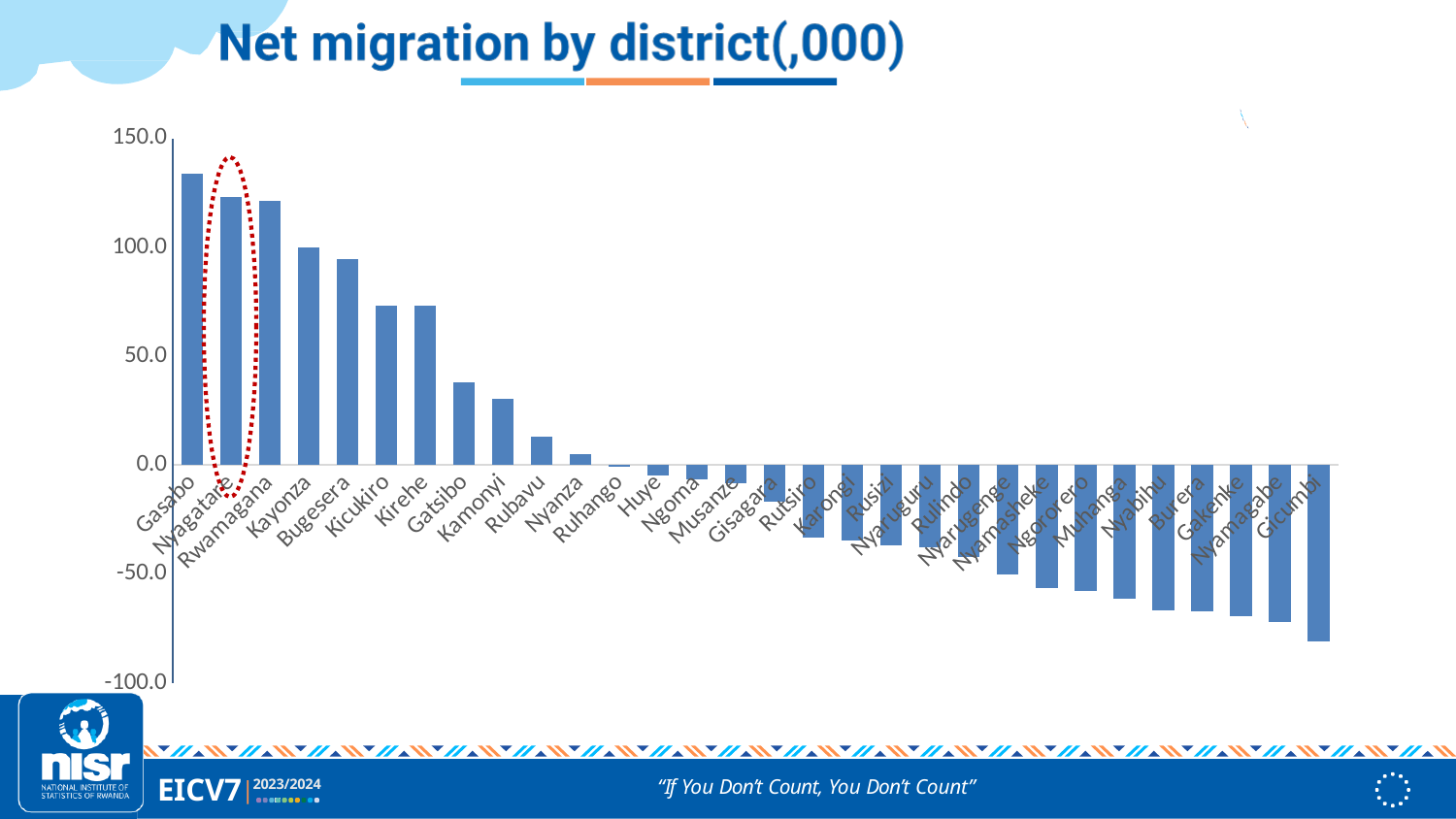
Is the value for Gasabo greater or less than 100.0? greater Is the value for Gatsibo greater or less than 50.0? less Is the value for Bugesera greater or less than 100.0? less Which district's bar is highlighted with a red dotted circle? Nyagatare Which district has the highest net migration? Gasabo Which district has the lowest net migration? Gicumbi Which has the larger net migration, Gasabo or Nyagatare? Gasabo Do the values generally rise or fall moving from left to right along the x axis? fall How many districts are shown on the x axis? 30 What is the title of the chart? Net migration by district(,000) What kind of chart is shown on the slide? bar chart